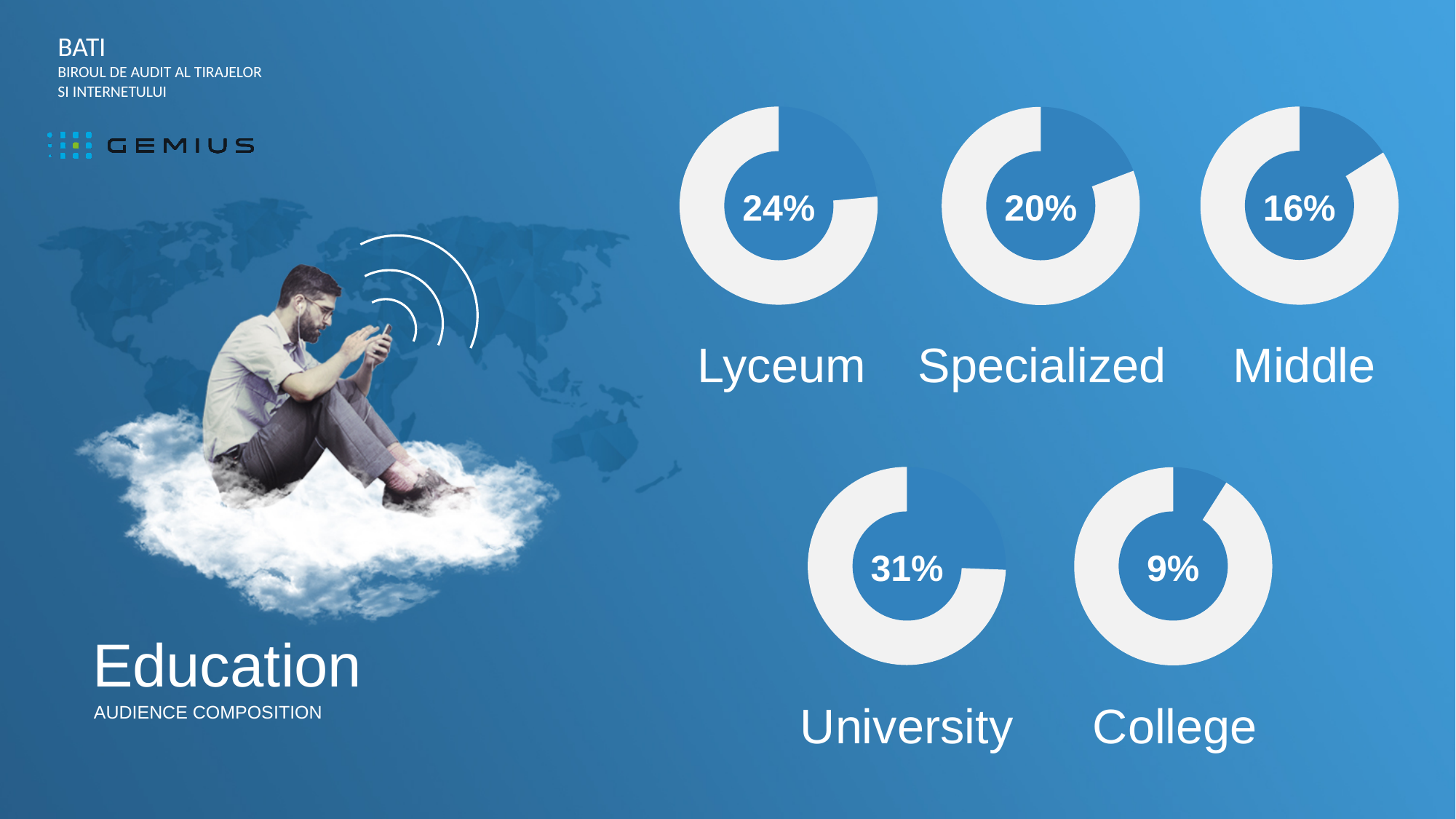
Across the five education donut charts, which category has the highest percentage? University Across the five education donut charts, which category has the lowest percentage? College What percentage is shown in the Middle donut chart? 16% What percentage is shown in the Specialized donut chart? 20% What percentage is shown in the University donut chart? 31% What is the difference between the Lyceum chart's percentage and the Middle chart's percentage? 8% What percentage is shown in the College donut chart? 9% How many donut charts are shown on the slide? 5 Which is larger, the Lyceum chart's percentage or the Specialized chart's percentage? Lyceum What is the difference between the University chart's percentage and the College chart's percentage? 22% What percentage is shown in the Lyceum donut chart? 24% What kind of chart is used to show the Lyceum value? Donut chart